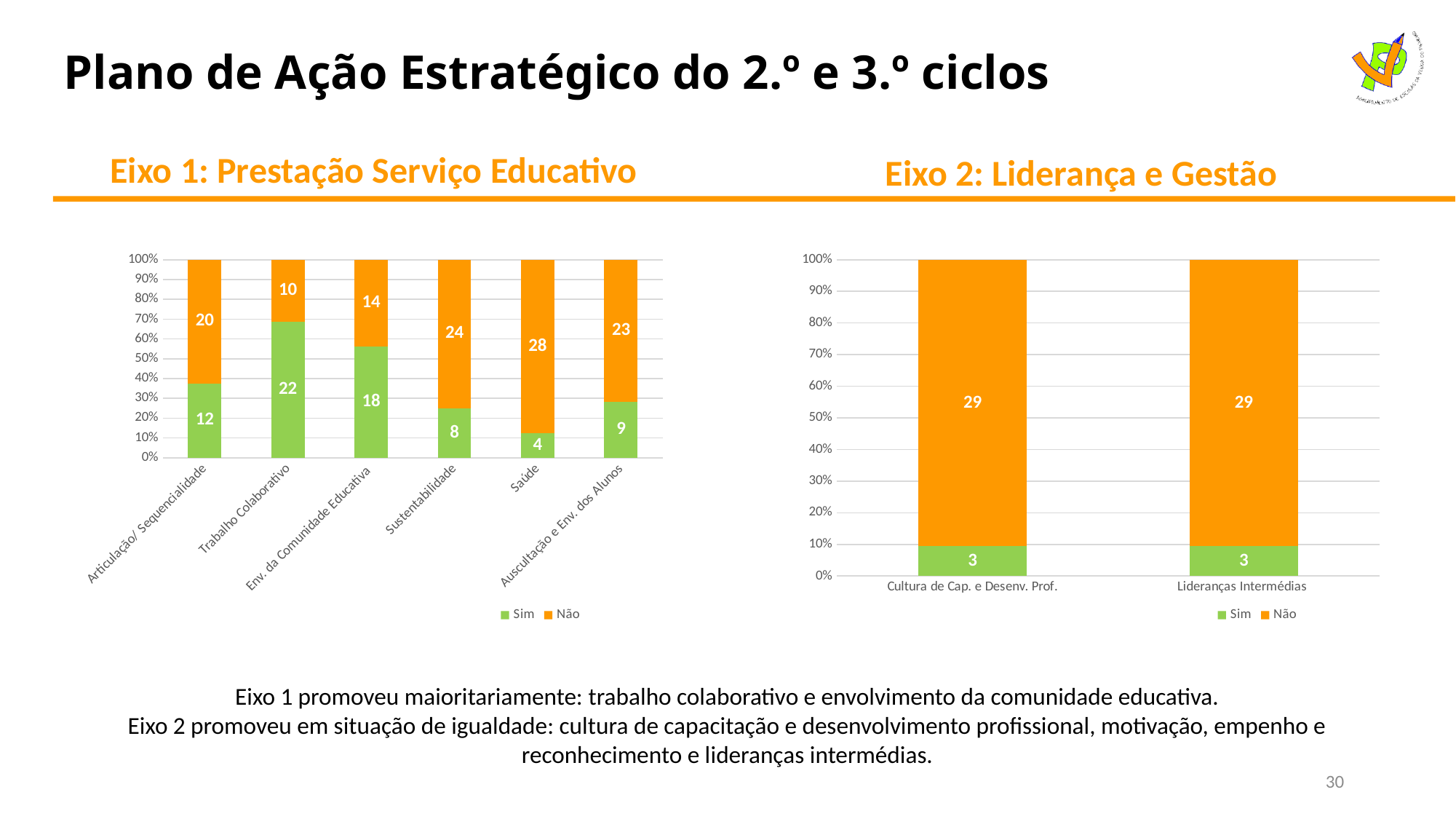
How many categories are shown in the Eixo 1 chart? 6 How many series does the legend of the Eixo 2 chart list? 2 In the Eixo 1 chart, which category has the lowest Sim value? Saúde In the Eixo 1 chart, what is the difference between the Não and Sim values for Sustentabilidade? 16 In the Eixo 2 chart, what is the Não value for Lideranças Intermédias? 29 In the Eixo 1 chart, what is the total of the stacked bar for Articulação/ Sequencialidade? 32 In the Eixo 2 chart, what is the Sim value for Cultura de Cap. e Desenv. Prof.? 3 In the Eixo 1 chart, what is the Sim value for Trabalho Colaborativo? 22 In the Eixo 1 chart, is the Sim value for Env. da Comunidade Educativa larger than its Não value? Yes In the Eixo 1 chart, which category has the highest Sim value? Trabalho Colaborativo What type of chart is the Eixo 2 chart? Stacked bar chart In the Eixo 1 chart, what is the Não value for Saúde? 28